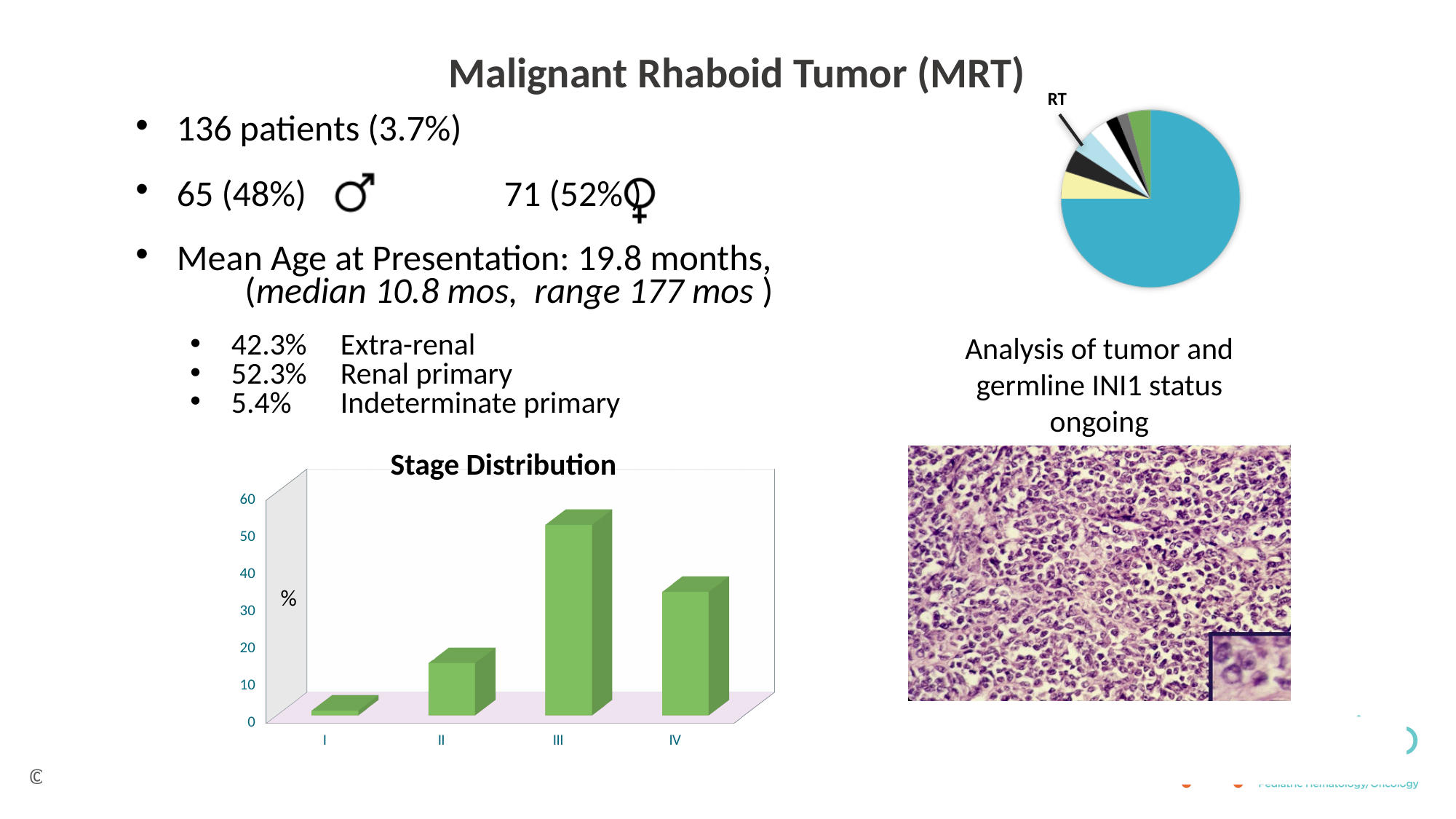
How many stage categories are shown on the x axis of the Stage Distribution chart? 4 Which stage has the highest value in the Stage Distribution chart? III In the Stage Distribution chart, is the value for stage IV greater or less than 20? greater Which stage has the lowest value in the Stage Distribution chart? I In the Stage Distribution chart, is the value for stage II greater or less than 20? less What is the title of the bar chart on the slide? Stage Distribution In the Stage Distribution chart, is the value for stage I greater or less than 10? less What kind of chart is the Stage Distribution chart? bar chart What label is shown on the y axis of the Stage Distribution chart? % In the Stage Distribution chart, which is larger, the value for stage II or stage IV? IV In the Stage Distribution chart, which is larger, the value for stage III or stage IV? III